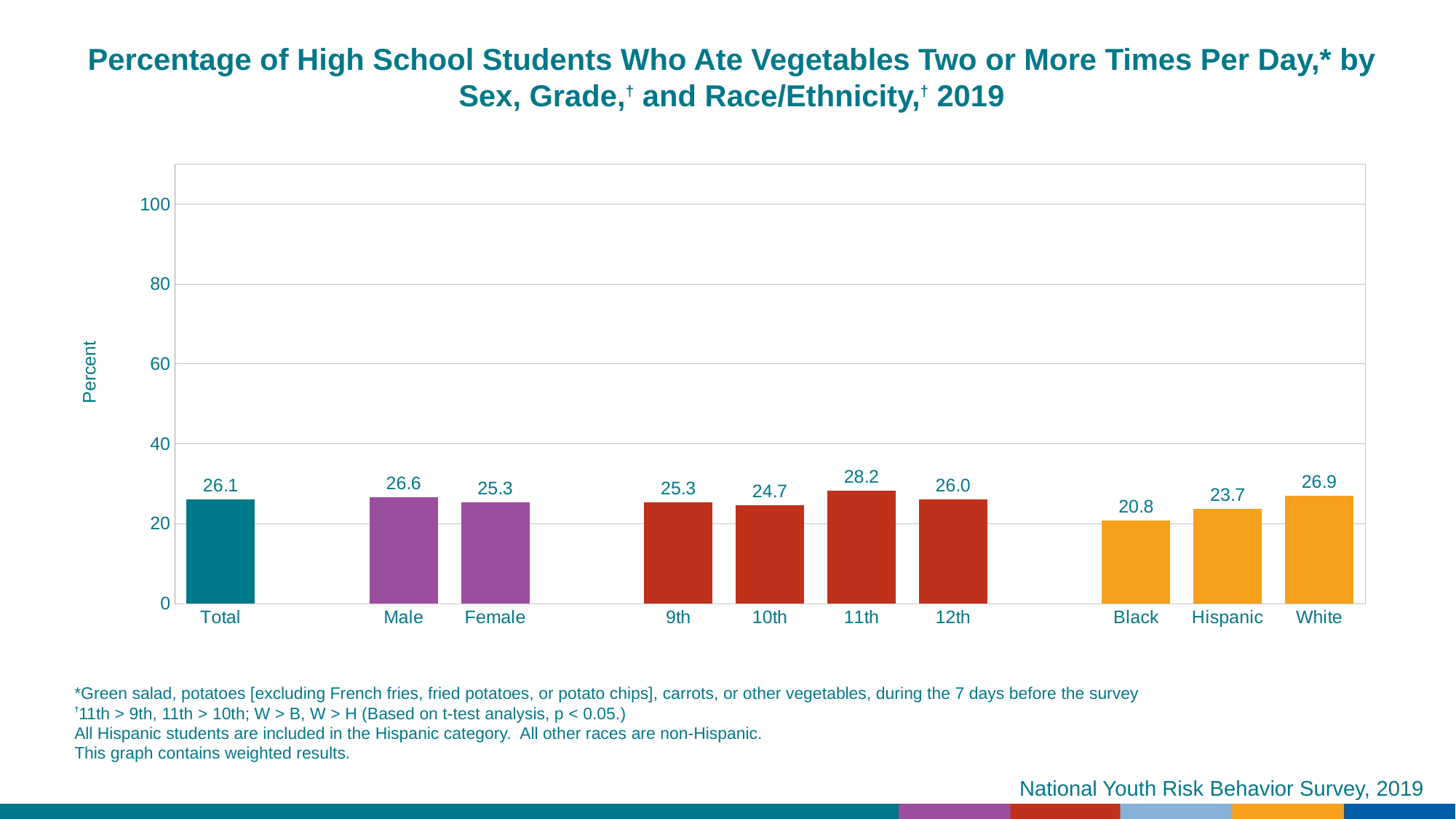
Which category has the lowest value? Black Is the value for Hispanic students greater or less than 40? less What is the value for Total? 26.1 Which category has the highest value? 11th What kind of chart is shown on the slide? bar chart How many categories are shown on the x axis? 10 What is the difference between the values for White and Black students? 6.1 What is the value for Black students? 20.8 Which is larger, the value for 11th grade or the value for 10th grade? 11th What is the label on the y axis? Percent What is the difference between the values for Male and Female? 1.3 What percentage of 11th grade students ate vegetables two or more times per day? 28.2